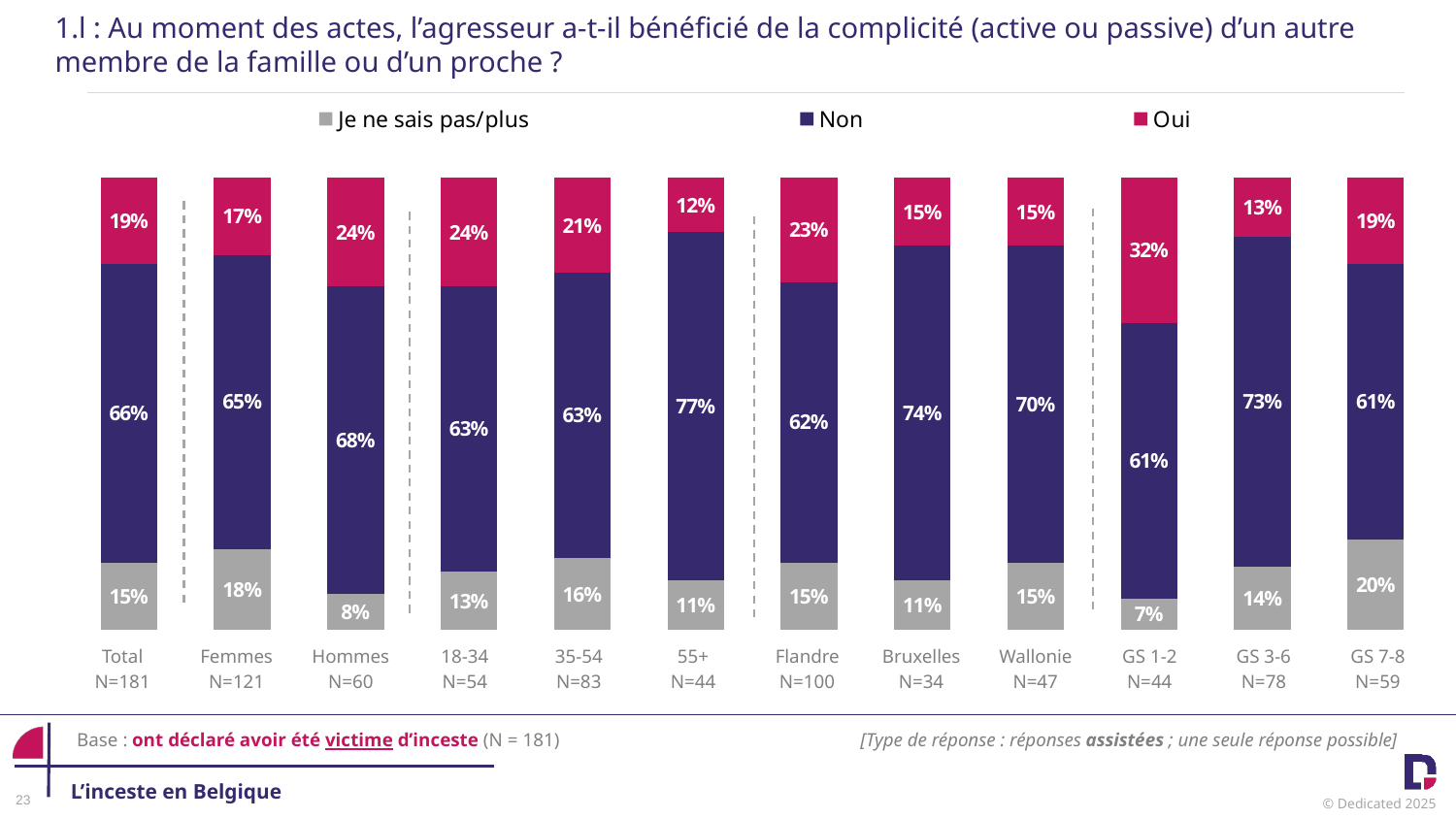
How many groups (bars) are shown on the chart? 12 What is the difference between the "Oui" percentages for Hommes and Femmes? 7 percentage points What is the "Non" value for the 55+ group? 77% Is the "Non" value larger for Bruxelles or for Flandre? Bruxelles What is the "Je ne sais pas/plus" value for Hommes? 8% Which group has the highest "Non" percentage? 55+ What percentage of respondents in the Total group answered "Oui"? 19% Which group has the lowest "Je ne sais pas/plus" percentage? GS 1-2 Which group has the highest "Oui" percentage? GS 1-2 What kind of chart is shown on the slide? Stacked bar chart What is the sample size (N) for the Wallonie group? N=47 How many series does the legend list? 3